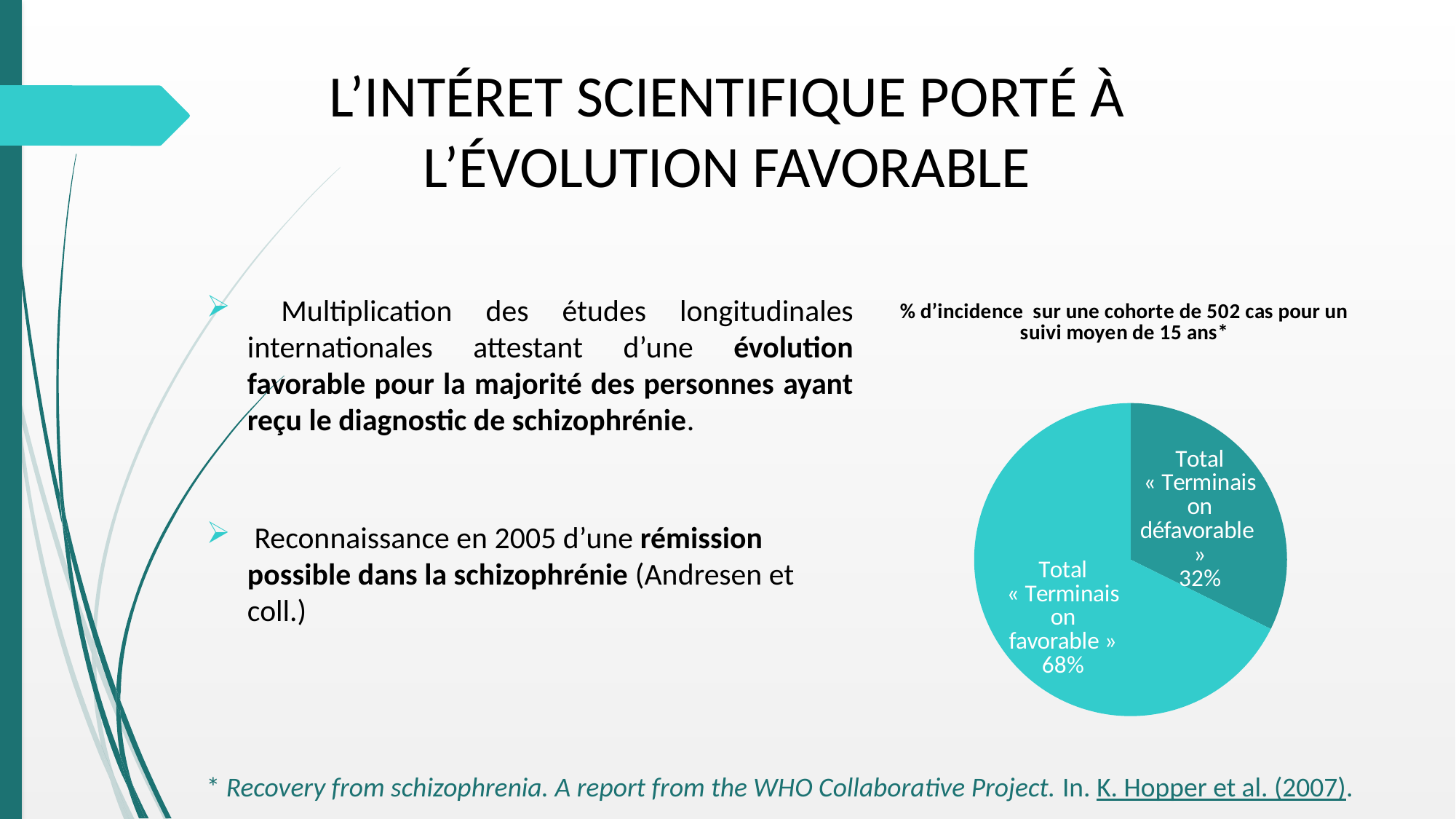
Which slice of the pie is the largest? Total « Terminaison favorable » Which is larger: Total « Terminaison favorable » or Total « Terminaison défavorable »? Total « Terminaison favorable » What is the difference between the favorable and défavorable slices? 36% What kind of chart is shown on the slide? pie chart How many slices does the pie chart have? 2 What share of the pie does Total « Terminaison défavorable » represent? 32% What is the value for Total « Terminaison défavorable »? 32% Which slice of the pie is the smallest? Total « Terminaison défavorable » What is the title of the pie chart? % d'incidence sur une cohorte de 502 cas pour un suivi moyen de 15 ans* How many cases are in the cohort mentioned in the chart title? 502 What is the value for Total « Terminaison favorable »? 68%